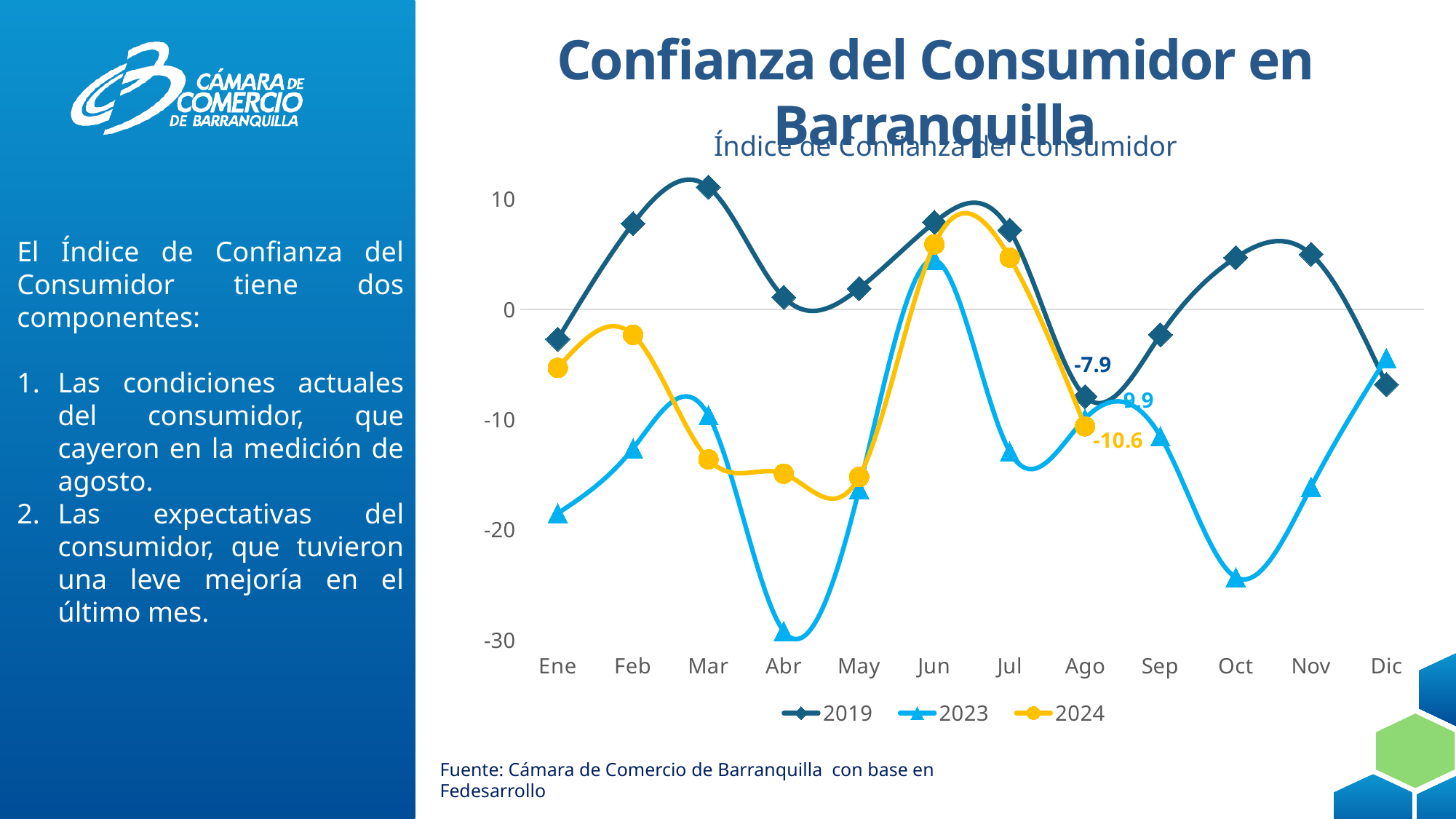
Is the value for 2023 in Abr greater or less than -20? less In which month does the 2024 series reach its highest value? Jun What is the value for 2024 in Ago? -10.6 What is the difference between the 2019 and 2024 values in Ago? 2.7 In which month does the 2023 series reach its lowest value? Abr Which series are listed in the legend? 2019, 2023, 2024 What is the value for 2019 in Ago? -7.9 How many series does the legend list? 3 How many months are shown on the x axis? 12 In Ago, which series has the higher value, 2019 or 2024? 2019 Is the value for 2019 in Mar greater or less than 10? greater What kind of chart is shown on the slide? line chart